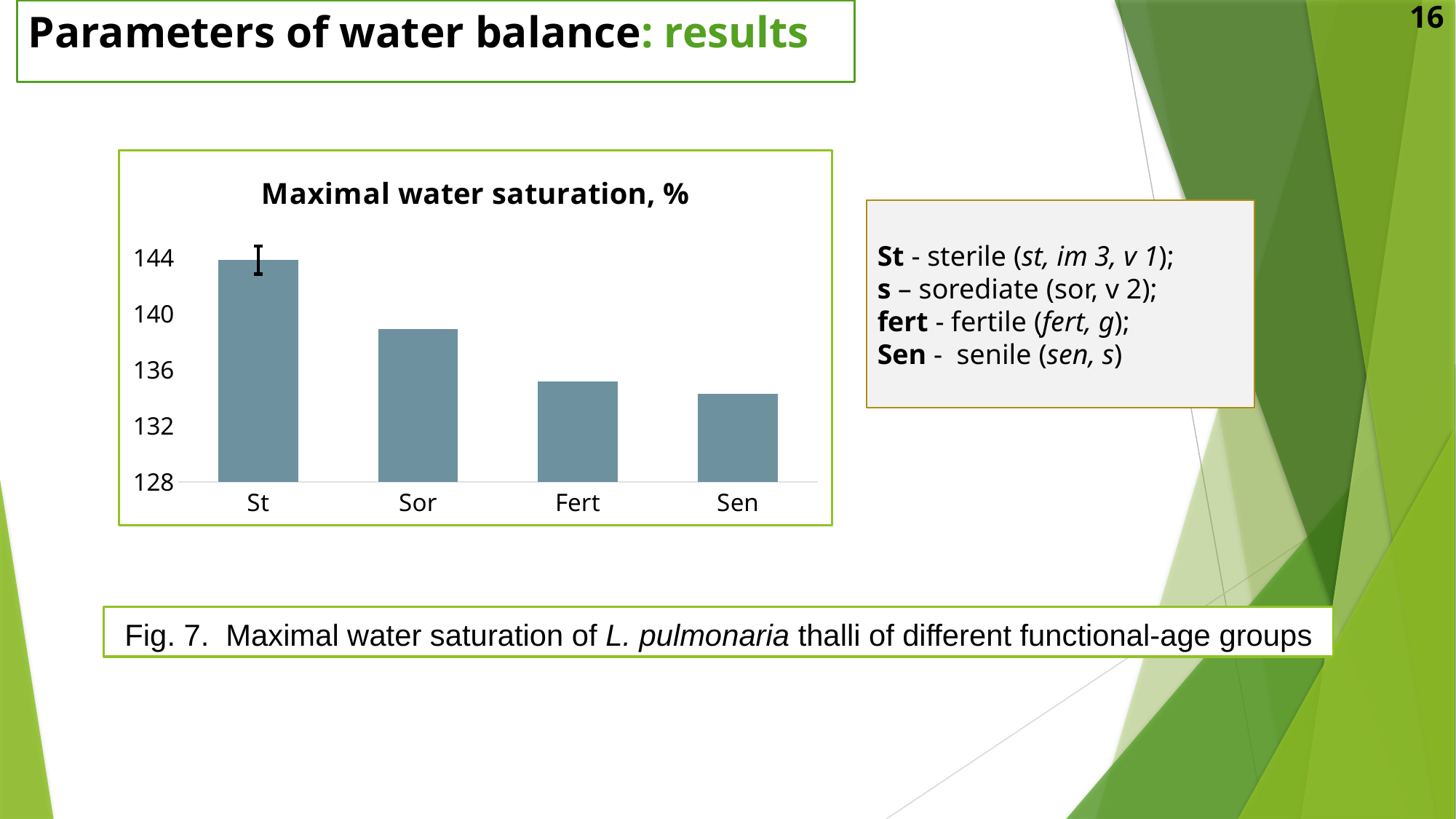
Is the value for St greater or less than 140? greater Do the values rise or fall from St to Sen along the x axis? fall Is the value for Sor greater or less than 140? less Is the value for Fert greater or less than 136? less How many categories are shown on the x axis of the chart? 4 What is the title of the chart? Maximal water saturation, % Which category has the lowest maximal water saturation? Sen Which is larger, the value for St or the value for Sor? St What kind of chart is shown on the slide? bar chart Which category has the highest maximal water saturation? St